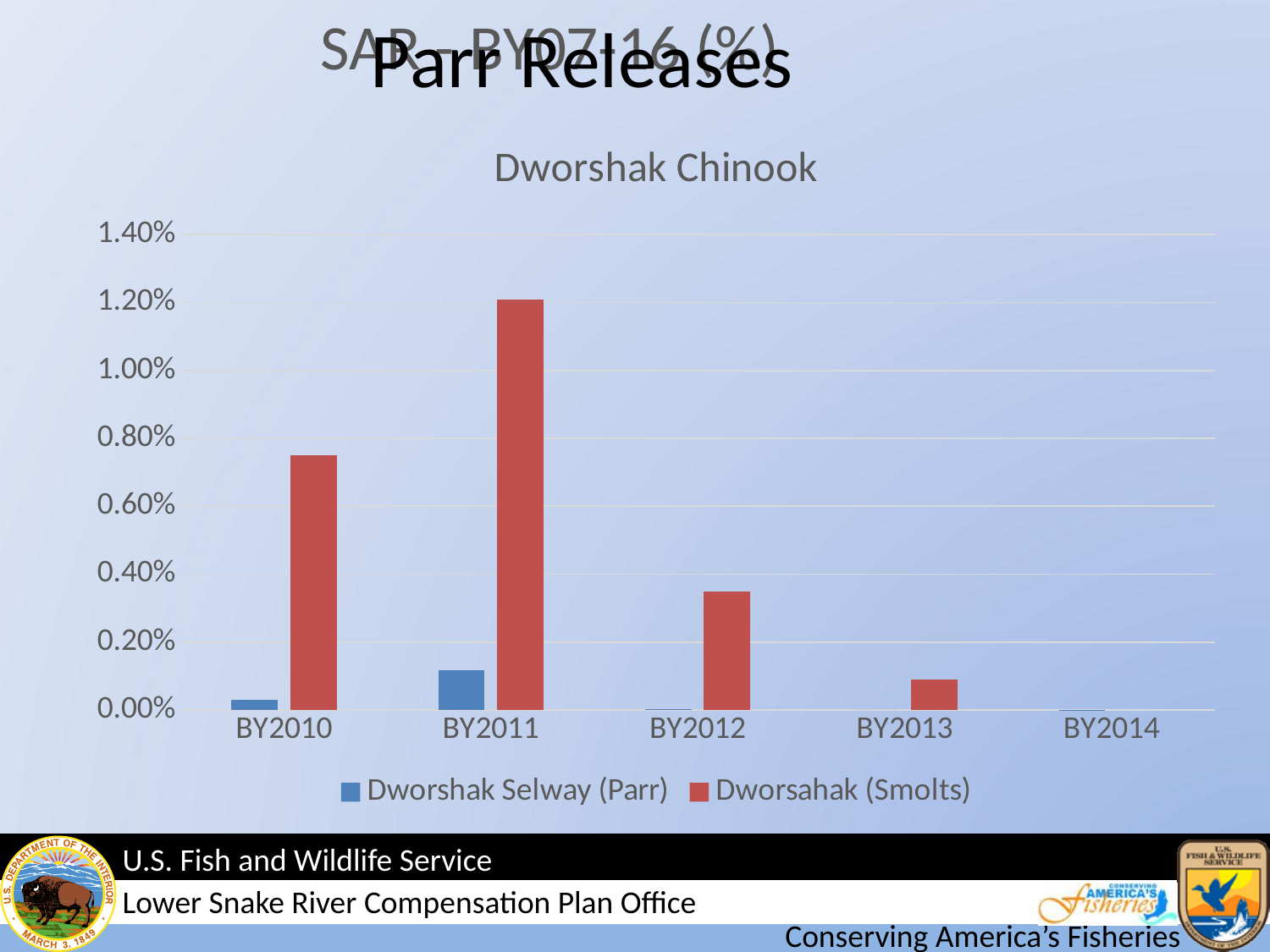
How many series does the legend list? 2 From BY2011 to BY2014, do the Dworsahak (Smolts) values rise or fall? fall Is the Dworsahak (Smolts) value for BY2010 greater or less than 0.60%? greater For BY2010, which series has the larger value, Dworshak Selway (Parr) or Dworsahak (Smolts)? Dworsahak (Smolts) Is the Dworsahak (Smolts) value for BY2011 greater or less than 1.00%? greater What kind of chart is shown on the slide? bar chart Which brood year has the highest value for Dworshak Selway (Parr)? BY2011 Is the Dworsahak (Smolts) value for BY2012 greater or less than 0.40%? less What is the title of the chart? Dworshak Chinook Which brood year has the highest value for Dworsahak (Smolts)? BY2011 How many brood-year categories are shown on the x axis? 5